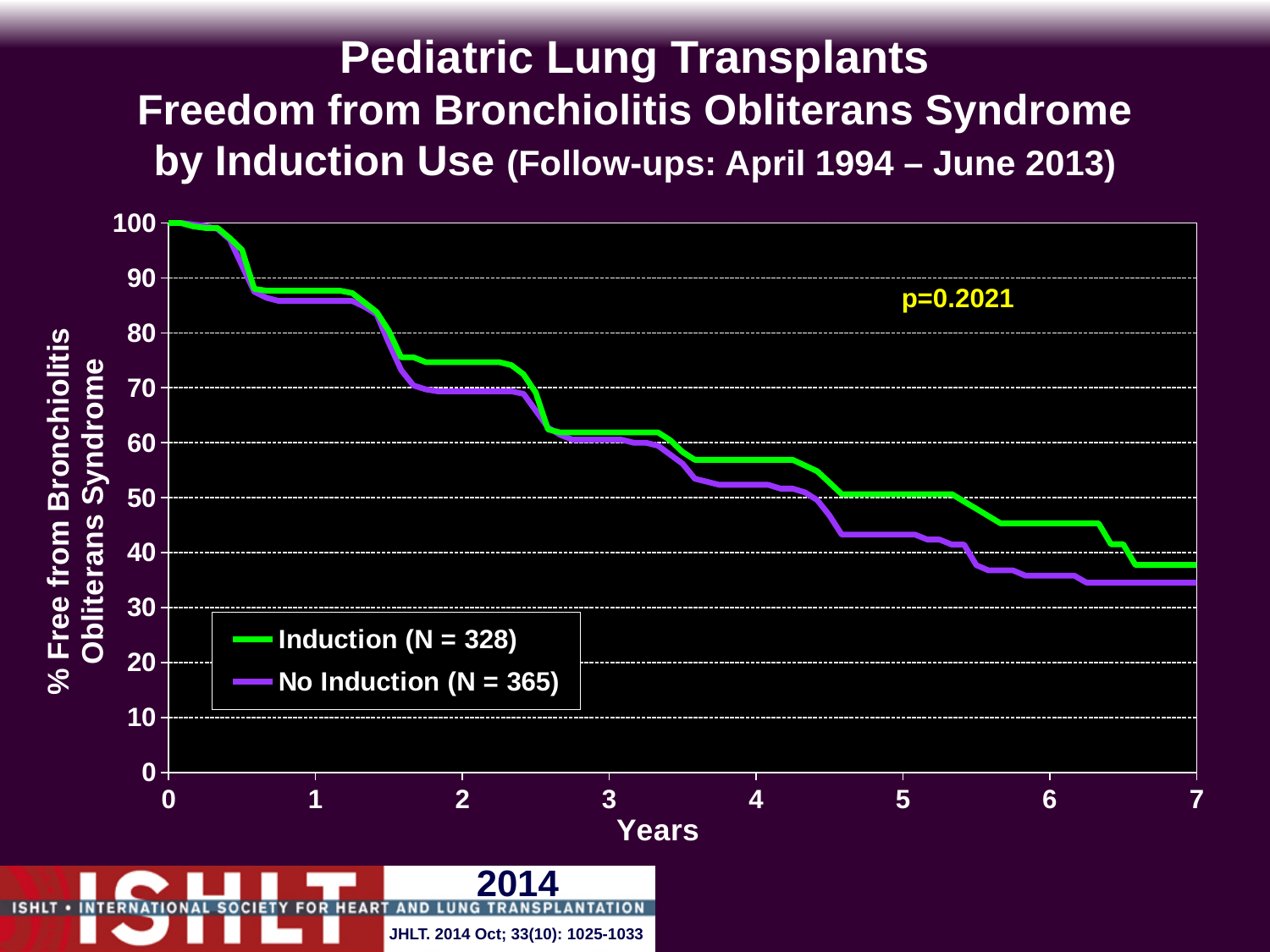
Do the curves rise or fall as years increase? fall Is the value for No Induction at 2 years greater or less than 60? greater Is the value for No Induction at 7 years greater or less than 40? less What is the N for the No Induction group in the legend? 365 Is the value for Induction at 3 years greater or less than 50? greater At 4 years, which curve is higher, Induction or No Induction? Induction What is the value of the Induction curve at 0 years? 100 What p-value is shown on the chart? p=0.2021 How many series does the legend list? 2 What kind of chart is shown on the slide? line chart